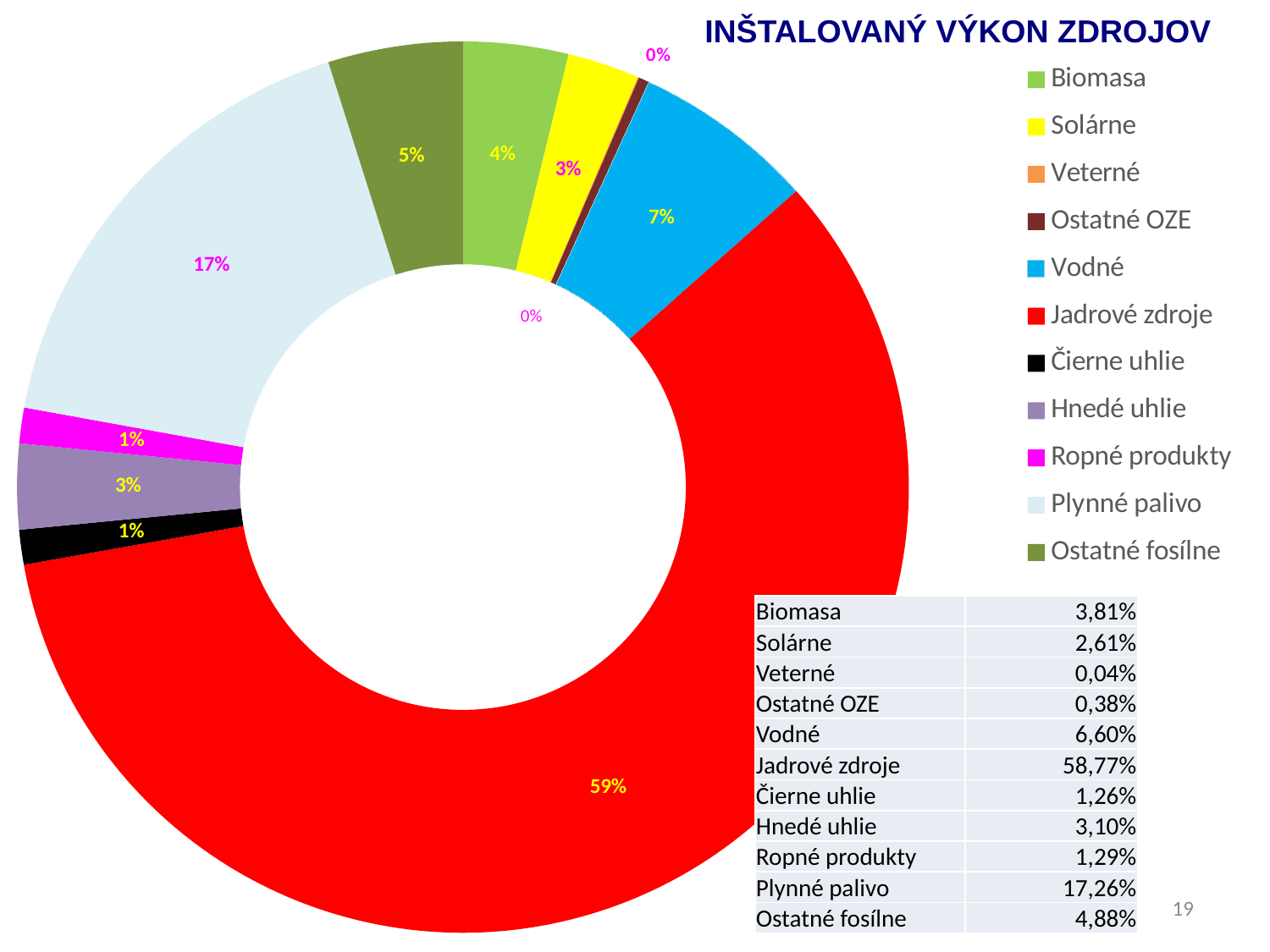
What percentage label is shown on the Jadrové zdroje slice? 59% Which slice is larger, Plynné palivo or Vodné? Plynné palivo Which colour represents Jadrové zdroje in the chart? red What percentage label is shown on the Vodné slice? 7% What is the title of the chart? INŠTALOVANÝ VÝKON ZDROJOV What is the difference between the Jadrové zdroje label and the Plynné palivo label on the chart? 42% Which slice is larger, Biomasa or Čierne uhlie? Biomasa What kind of chart is shown on the slide? doughnut chart How many entries does the chart legend list? 11 What percentage label is shown on the Plynné palivo slice? 17% Which category has the largest share of the chart? Jadrové zdroje What percentage label is shown on the Ostatné fosílne slice? 5%